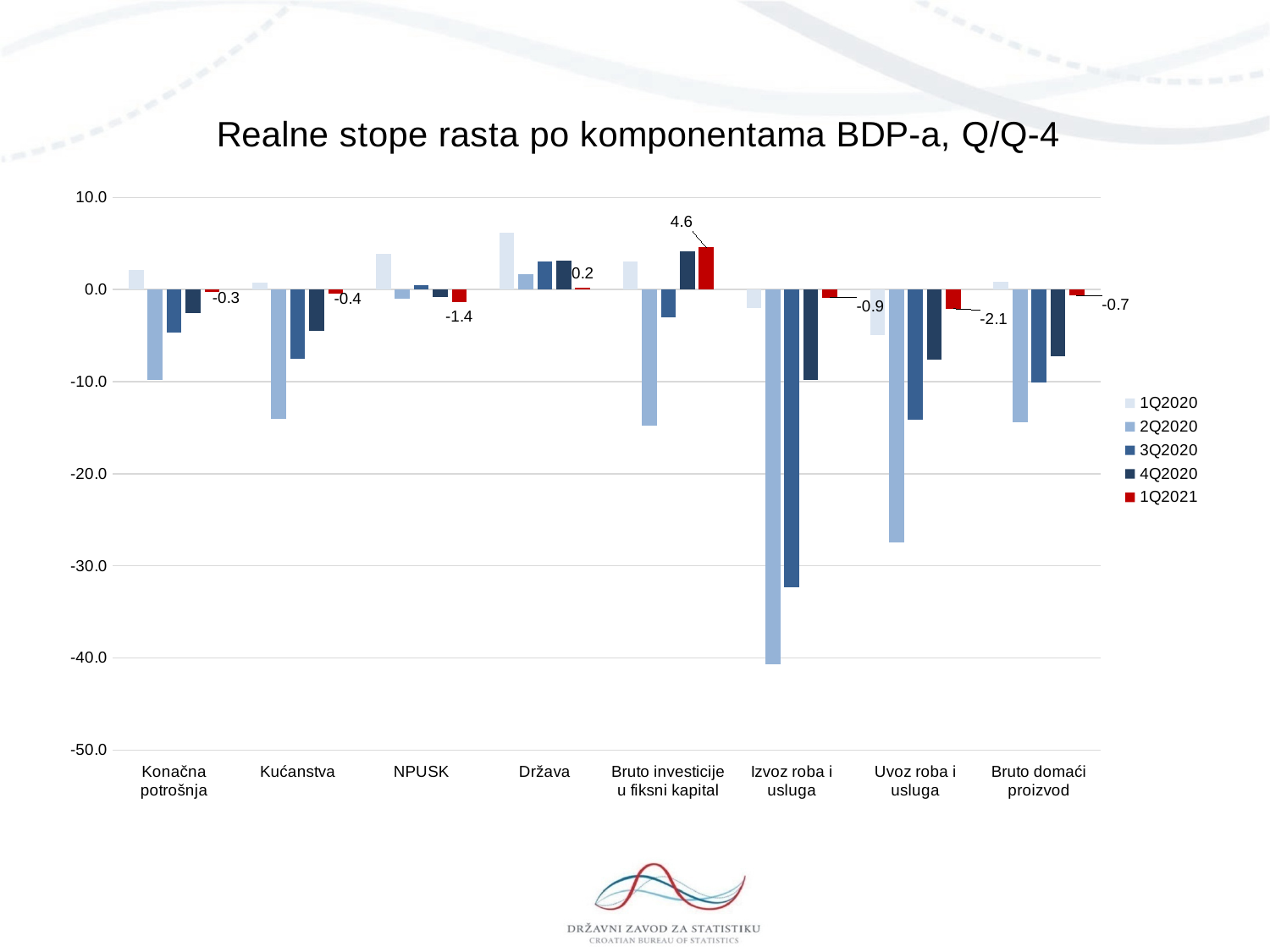
How many series does the legend list? 5 What is the 1Q2021 value for Uvoz roba i usluga? -2.1 How many categories are shown on the x axis? 8 Which category has the lowest 1Q2021 value? Uvoz roba i usluga What kind of chart is shown on the slide? Bar chart What is the 1Q2021 value for Bruto investicije u fiksni kapital? 4.6 Which has the larger 1Q2021 value, Država or NPUSK? Država What is the 1Q2021 value for Bruto domaći proizvod? -0.7 What is the 1Q2021 value for NPUSK? -1.4 What is the difference between the 1Q2021 values for Bruto investicije u fiksni kapital and Uvoz roba i usluga? 6.7 Is the 2Q2020 value for Uvoz roba i usluga greater or less than -20.0? less Which category has the highest 1Q2021 value? Bruto investicije u fiksni kapital